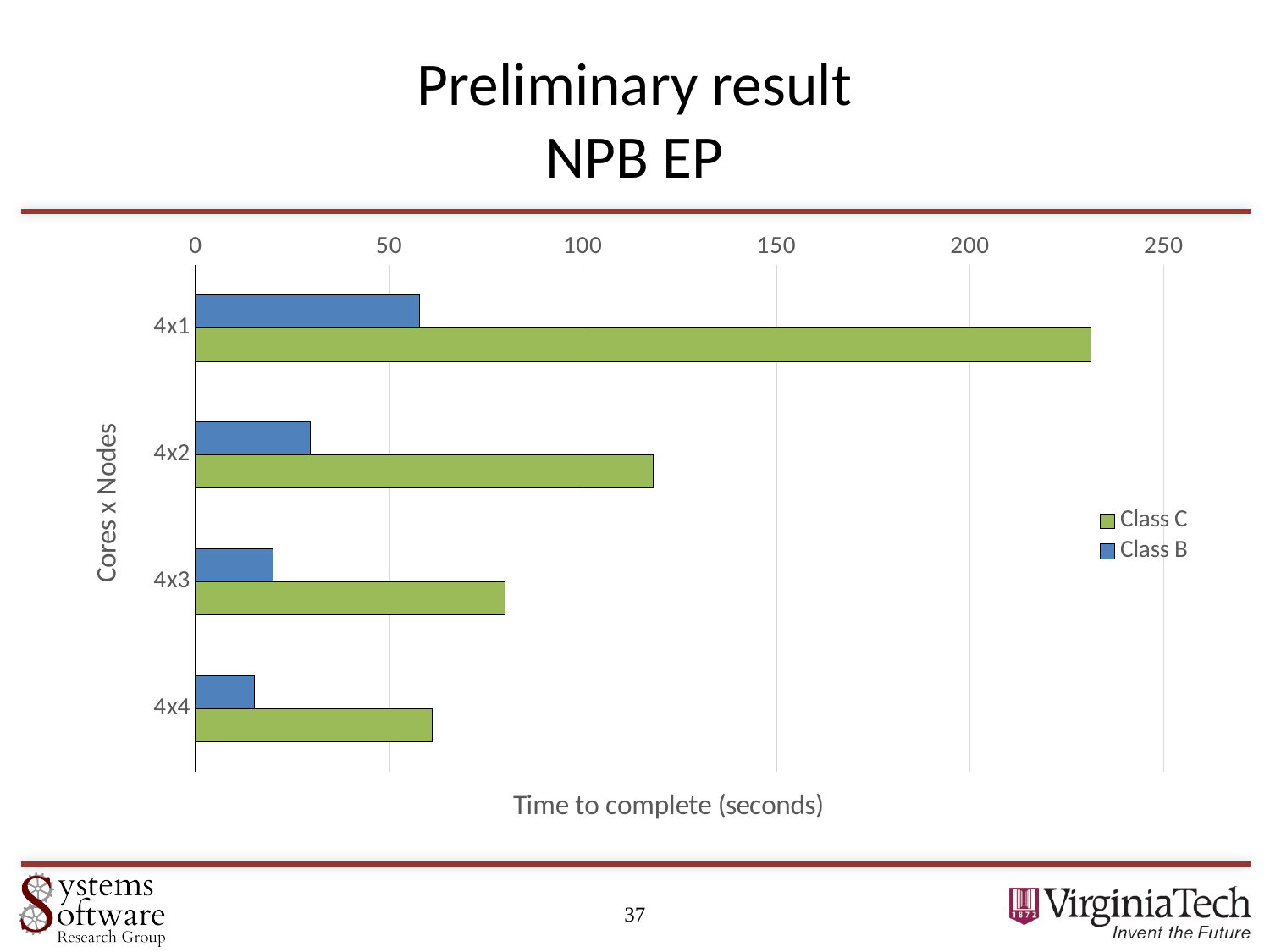
What is the label of the horizontal axis? Time to complete (seconds) Which configuration has the lowest Class B time to complete? 4x4 Is the Class C value for 4x1 greater or less than 200? greater What kind of chart is shown on the slide? bar chart Is the Class B value for 4x2 greater or less than 50? less Which configuration has the highest Class C time to complete? 4x1 Do the Class C times rise or fall as the configuration goes from 4x1 to 4x4? fall How many categories (Cores x Nodes configurations) are shown on the y axis? 4 Is the Class C value for 4x3 greater or less than 100? less Which is larger for the 4x4 configuration, the Class B time or the Class C time? Class C How many series does the legend list? 2